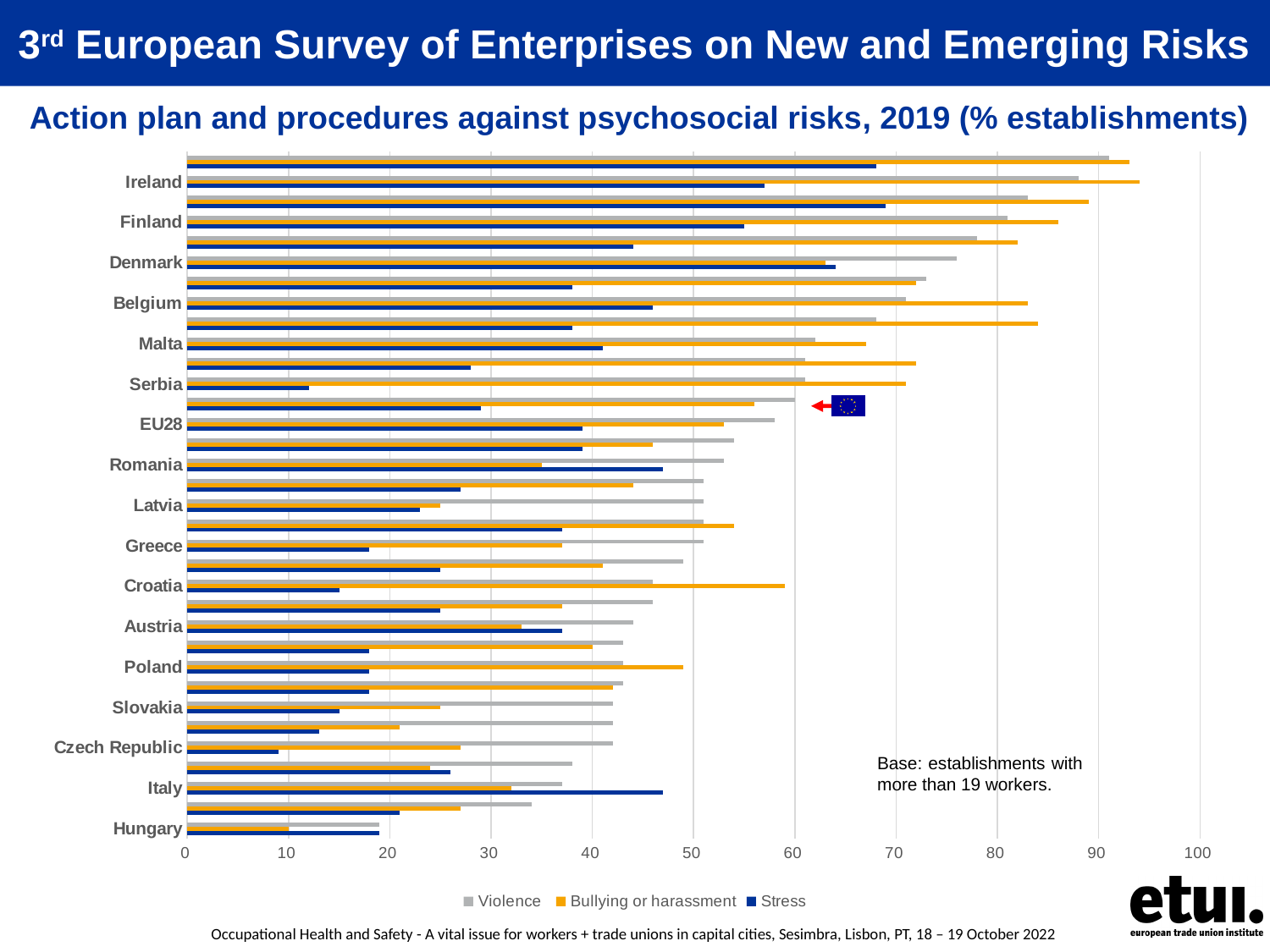
What is the title of the chart? Action plan and procedures against psychosocial risks, 2019 (% establishments) Is the Stress value for Italy greater or less than 40? greater Is the Bullying or harassment value for Ireland greater or less than 90? greater Is the Violence value for EU28 greater or less than 60? less What kind of chart is shown on the slide? bar chart How many series does the legend list? 3 For Italy, which is larger: the Stress value or the Violence value? Stress Which series is shown in blue in the legend? Stress For Serbia, which is larger: the Violence value or the Stress value? Violence